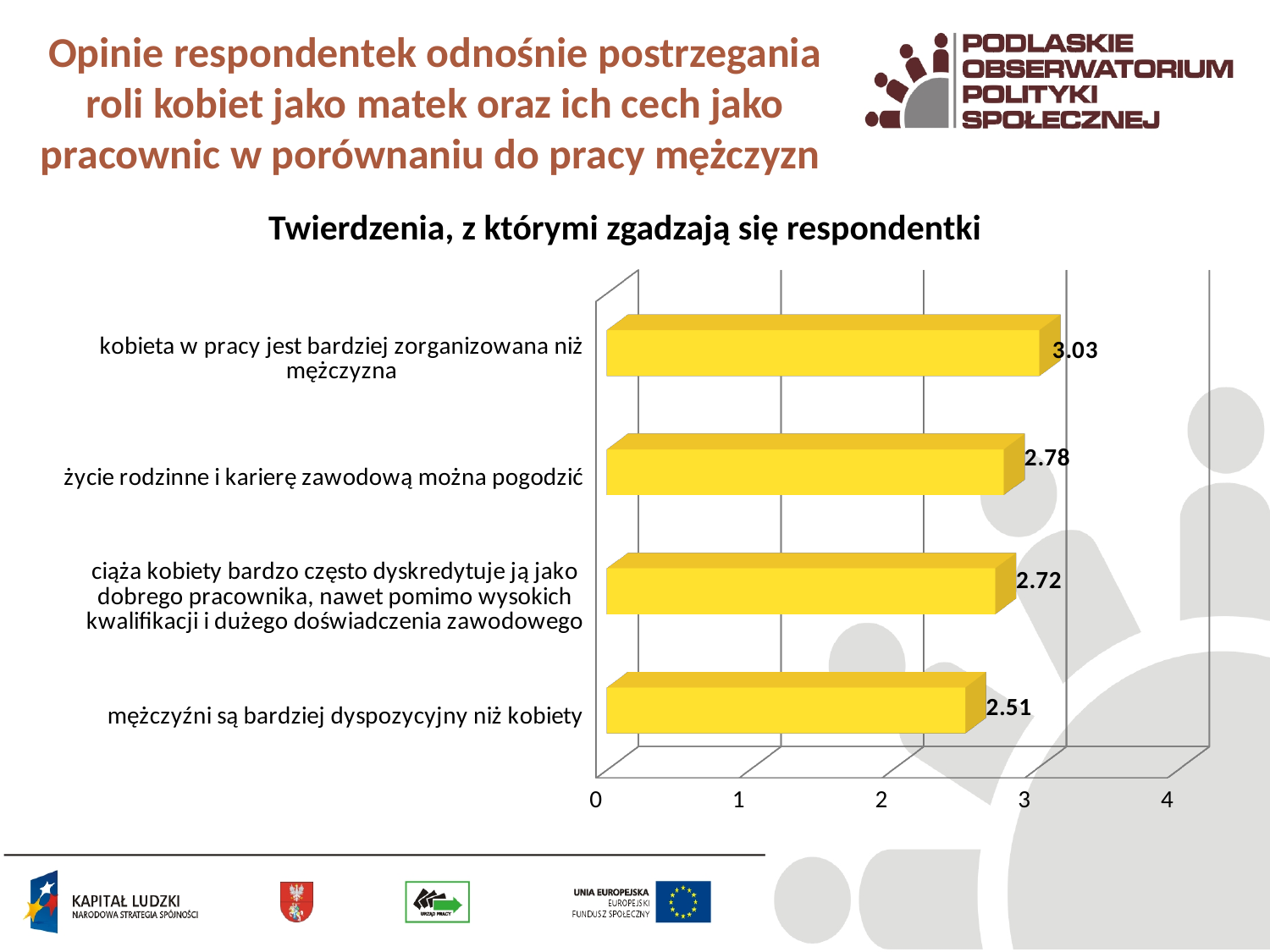
Which statement has the highest value? kobieta w pracy jest bardziej zorganizowana niż mężczyzna Which is larger: the value for "życie rodzinne i karierę zawodową można pogodzić" or the value for "mężczyźni są bardziej dyspozycyjny niż kobiety"? życie rodzinne i karierę zawodową można pogodzić What kind of chart is shown on the slide? bar chart What is the value for "kobieta w pracy jest bardziej zorganizowana niż mężczyzna"? 3.03 Which statement has the lowest value? mężczyźni są bardziej dyspozycyjny niż kobiety What is the difference between the highest value (3.03) and the lowest value (2.51)? 0.52 Is the value for "kobieta w pracy jest bardziej zorganizowana niż mężczyzna" greater or less than 3? greater What is the value for "mężczyźni są bardziej dyspozycyjny niż kobiety"? 2.51 What is the value for "życie rodzinne i karierę zawodową można pogodzić"? 2.78 How many statements (bars) are shown in the chart? 4 What is the title of the chart? Twierdzenia, z którymi zgadzają się respondentki What is the value for the statement about pregnancy discrediting a woman as a good employee ("ciąża kobiety bardzo często dyskredytuje ją...")? 2.72